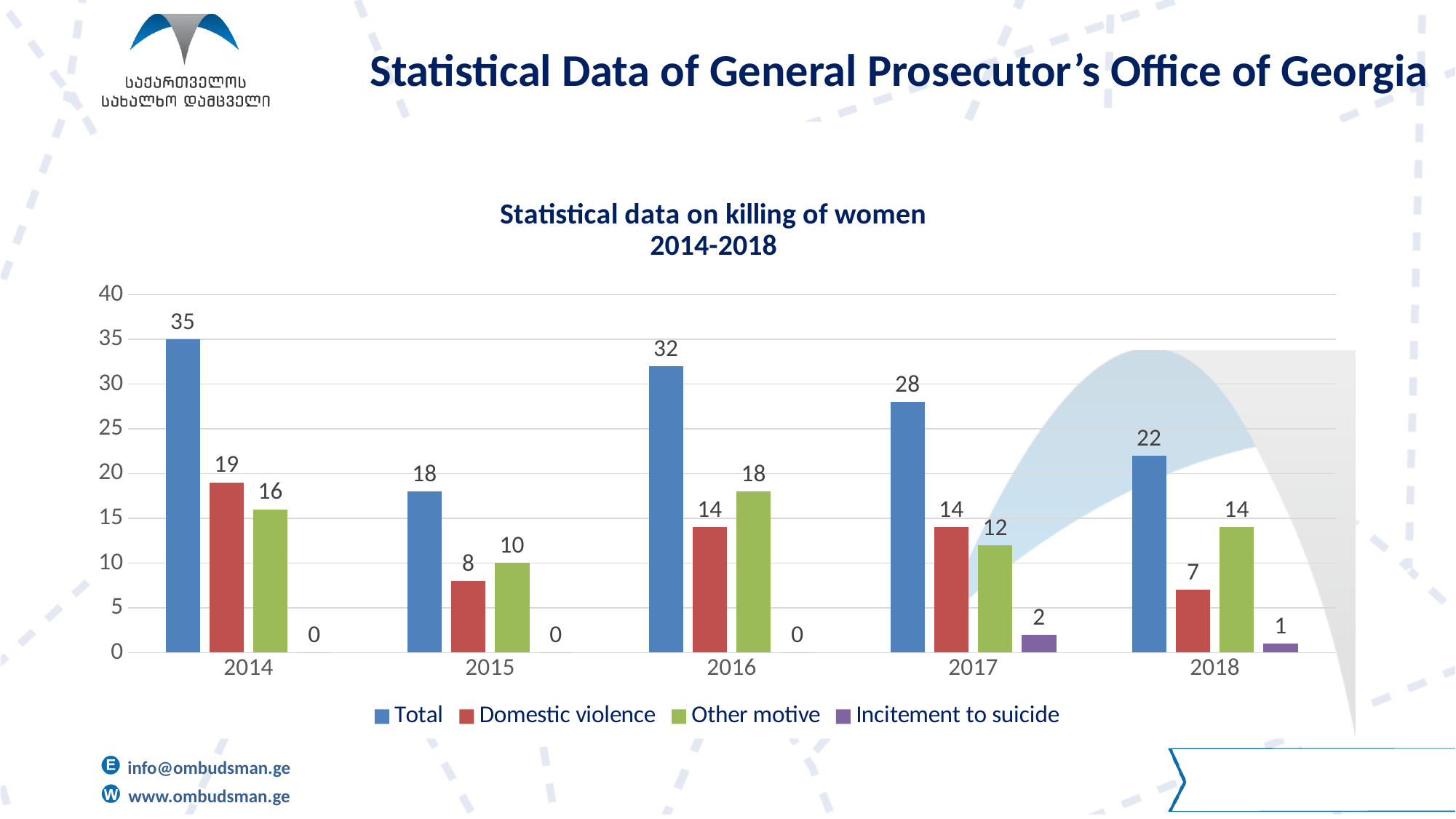
What is the title of the chart? Statistical data on killing of women 2014-2018 How many years are shown on the x axis? 5 Which is larger, the Domestic violence value for 2014 or the Other motive value for 2014? Domestic violence How many series does the legend list? 4 What is the Total value for 2016? 32 What kind of chart is shown on the slide? Bar chart What is the Incitement to suicide value for 2017? 2 What is the Other motive value for 2018? 14 What is the difference between the Total values for 2014 and 2018? 13 What is the Domestic violence value for 2015? 8 Which year has the highest Total value? 2014 Which year has the lowest Total value? 2015